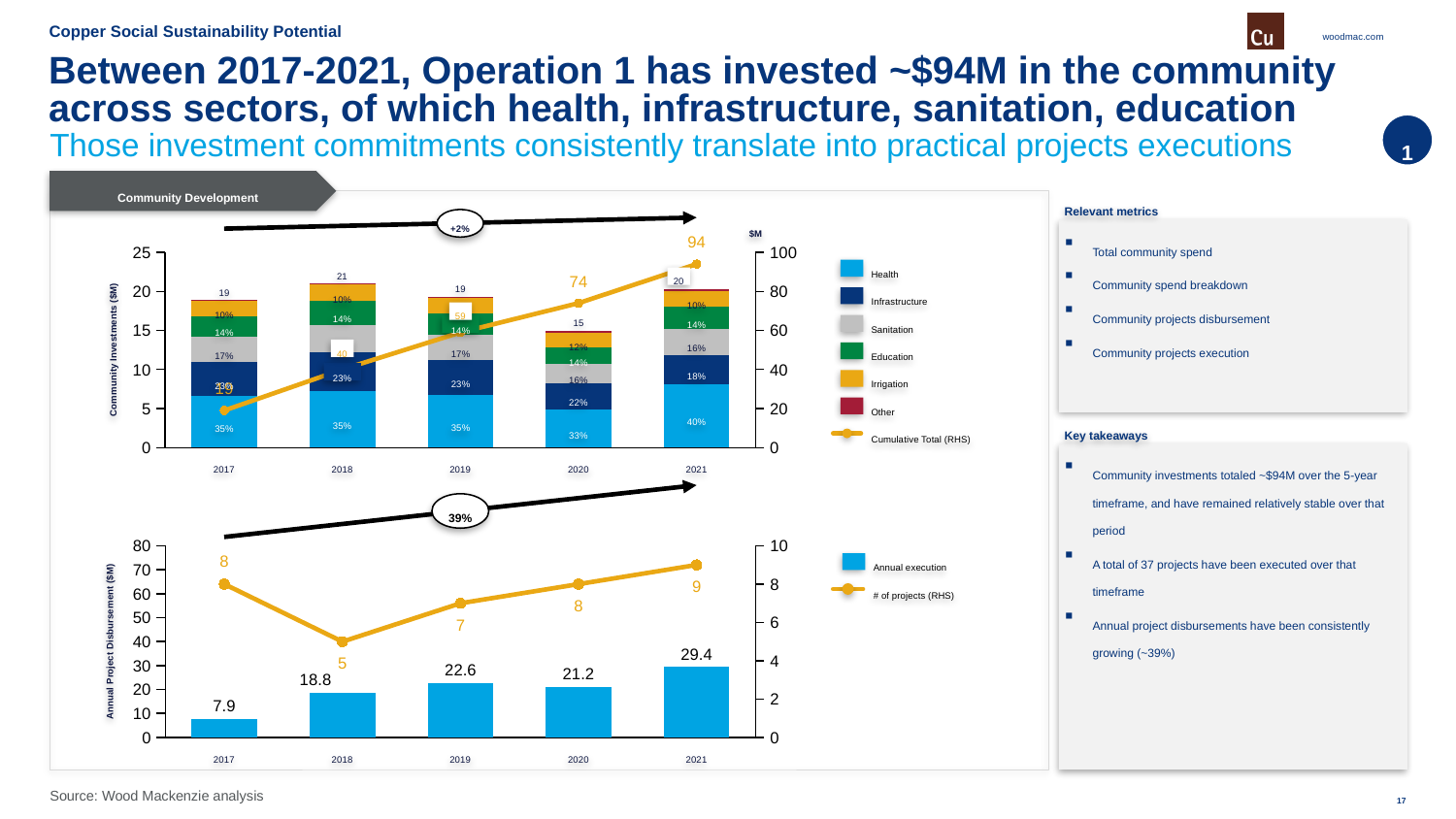
In the bottom chart, what is the difference in annual project disbursement between 2021 and 2017? 21.5 In the bottom chart, how many years are shown on the x axis? 5 In the bottom chart, which year has the highest annual project disbursement? 2021 In the bottom chart, is the annual project disbursement for 2020 larger or smaller than for 2019? smaller In the bottom chart, what is the annual project disbursement for 2019? 22.6 In the top chart (Community Development), what is the total community investment for 2018? 21 In the top chart (Community Development), what is the cumulative total value shown for 2021? 94 In the top chart (Community Development), how many entries does the legend list? 7 In the bottom chart, how many projects are shown for 2018? 5 In the top chart (Community Development), which year has the lowest total community investment? 2020 In the top chart (Community Development), what is the difference between the cumulative total in 2019 and in 2018? 19 In the top chart (Community Development), what share of the 2021 bar is Health? 40%